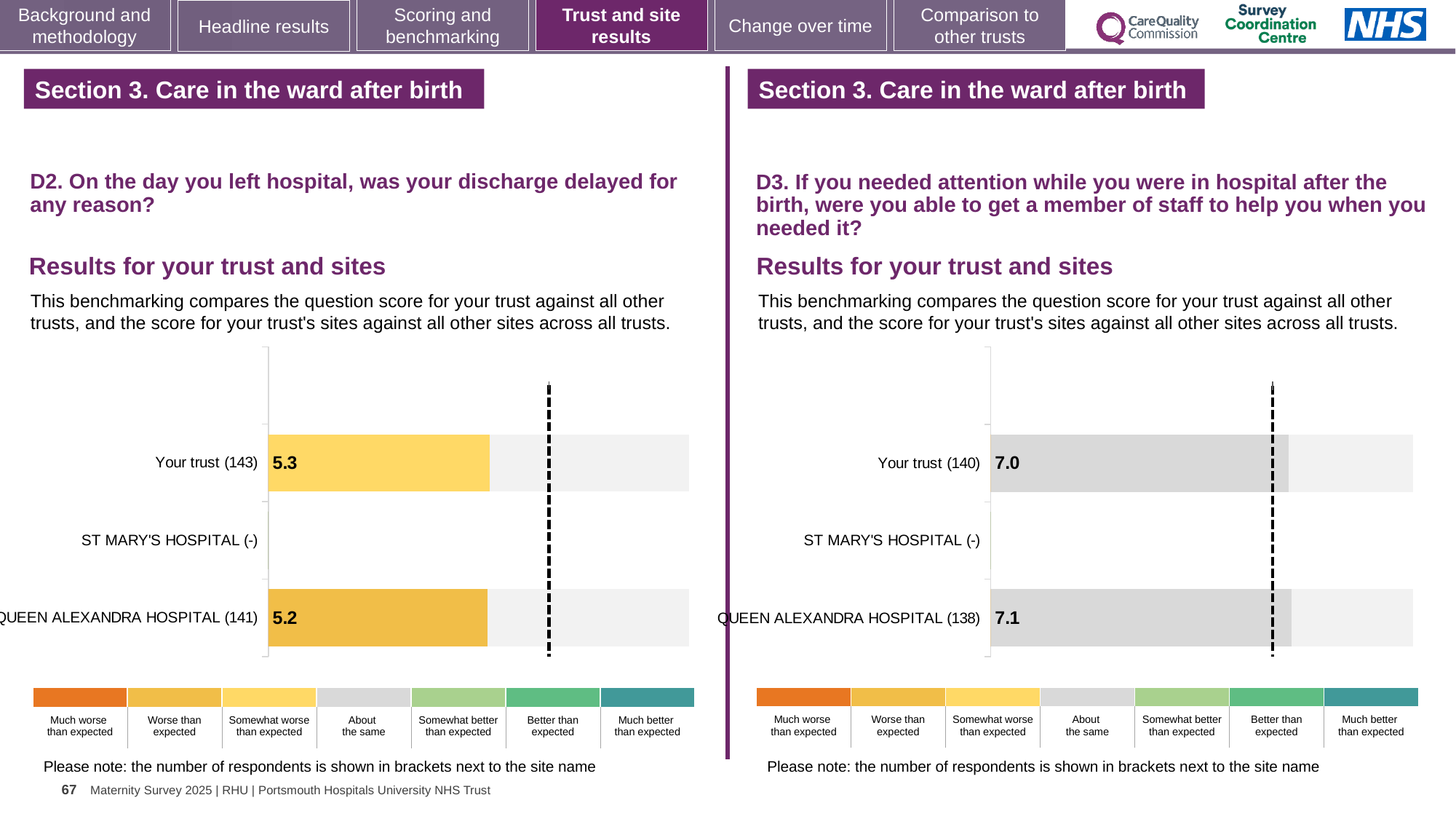
In the left chart (D2), what is the score for Your trust? 5.3 In the left chart (D2), how many respondents are shown in brackets for QUEEN ALEXANDRA HOSPITAL? 141 In the right chart (D3), what is the score for QUEEN ALEXANDRA HOSPITAL? 7.1 In the right chart (D3), which has the higher score: Your trust or QUEEN ALEXANDRA HOSPITAL? QUEEN ALEXANDRA HOSPITAL What kind of chart is used for the D3 results on the right? Bar chart In the left chart (D2), which has the higher score: Your trust or QUEEN ALEXANDRA HOSPITAL? Your trust In the left chart (D2), what is the difference between the score for Your trust and the score for QUEEN ALEXANDRA HOSPITAL? 0.1 In the left chart (D2), what is the score for QUEEN ALEXANDRA HOSPITAL? 5.2 In the right chart (D3), what is the difference between the score for QUEEN ALEXANDRA HOSPITAL and the score for Your trust? 0.1 In the right chart (D3), what is the score for Your trust? 7.0 How many categories (rows) are listed on the left chart (D2)? 3 In the right chart (D3), which benchmarking category does the colour of the Your trust bar correspond to? About the same